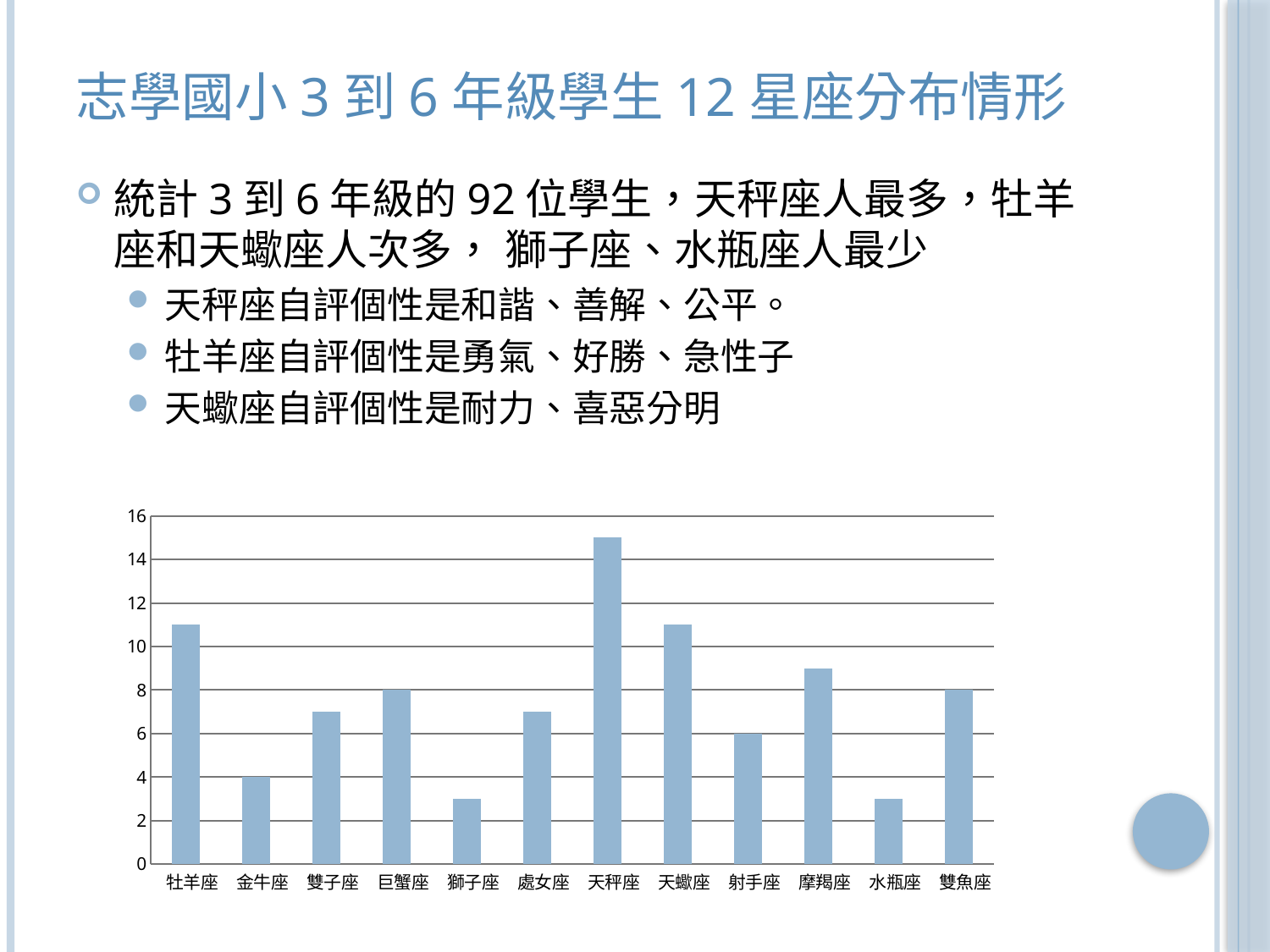
Which zodiac sign has the highest bar in the chart? 天秤座 What is the value for 巨蟹座 in the chart? 8 What is the difference between the values for 巨蟹座 and 金牛座? 4 Is the value for 天秤座 greater or less than 14? greater How many categories (zodiac signs) are shown on the x axis of the chart? 12 Is the value for 摩羯座 greater or less than 8? greater What is the value for 射手座 in the chart? 6 Which has a larger value, 天秤座 or 牡羊座? 天秤座 What is the value for 金牛座 in the chart? 4 What type of chart is shown on the slide? bar chart What is the value for 雙魚座 in the chart? 8 Is the value for 獅子座 greater or less than 4? less